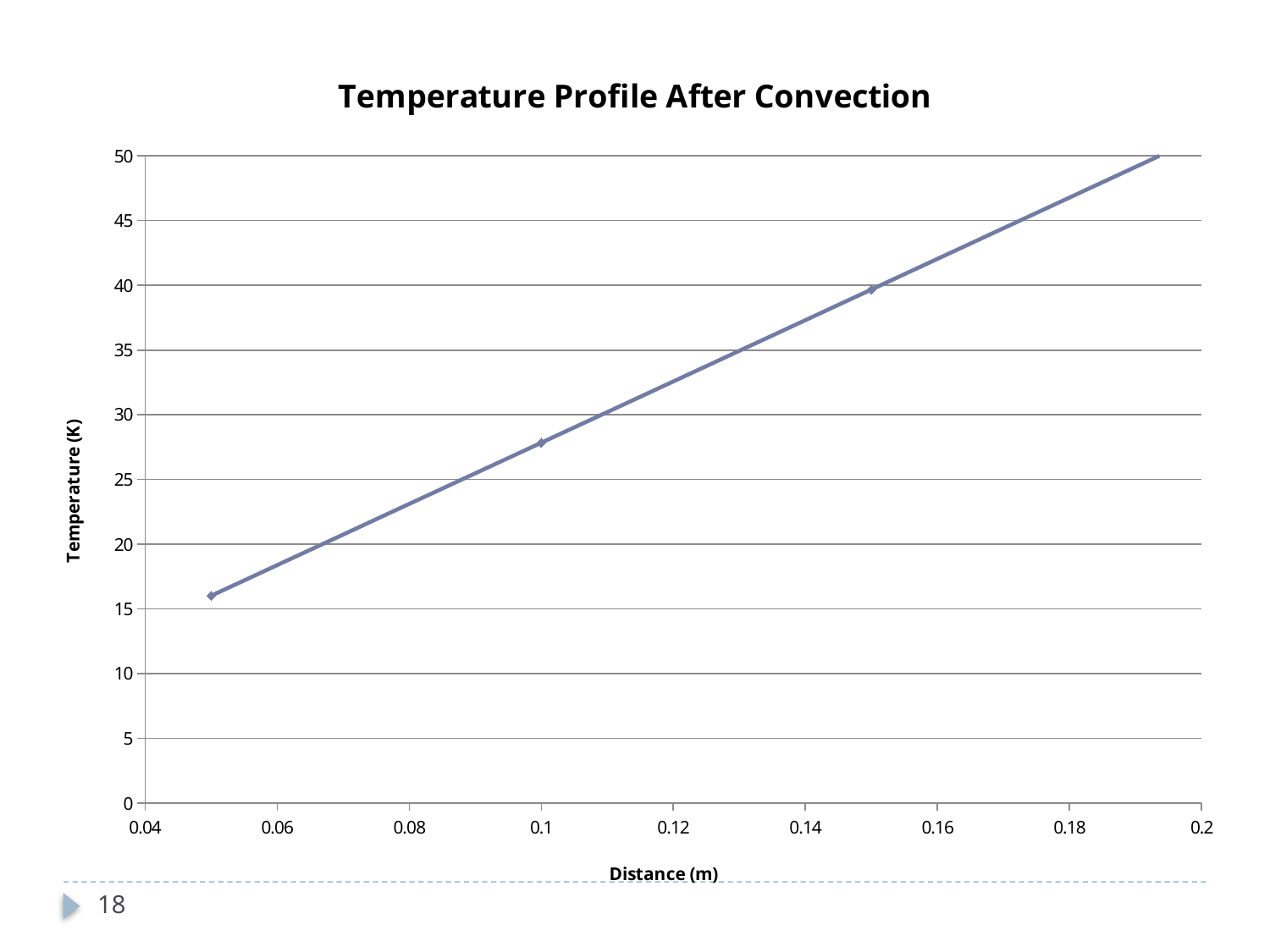
Does the temperature rise or fall as distance increases along the x axis? rise What is the label of the vertical axis? Temperature (K) Is the temperature at a distance of 0.05 m greater or less than 15? greater Is the temperature at a distance of 0.1 m greater or less than 30? less Is the temperature at a distance of 0.15 m greater or less than 45? less Which has the higher temperature: the point at 0.05 m or the point at 0.15 m? 0.15 m Which has the lower temperature: the point at 0.1 m or the point at 0.15 m? 0.1 m What is the title of the chart? Temperature Profile After Convection What kind of chart is shown on the slide? line chart